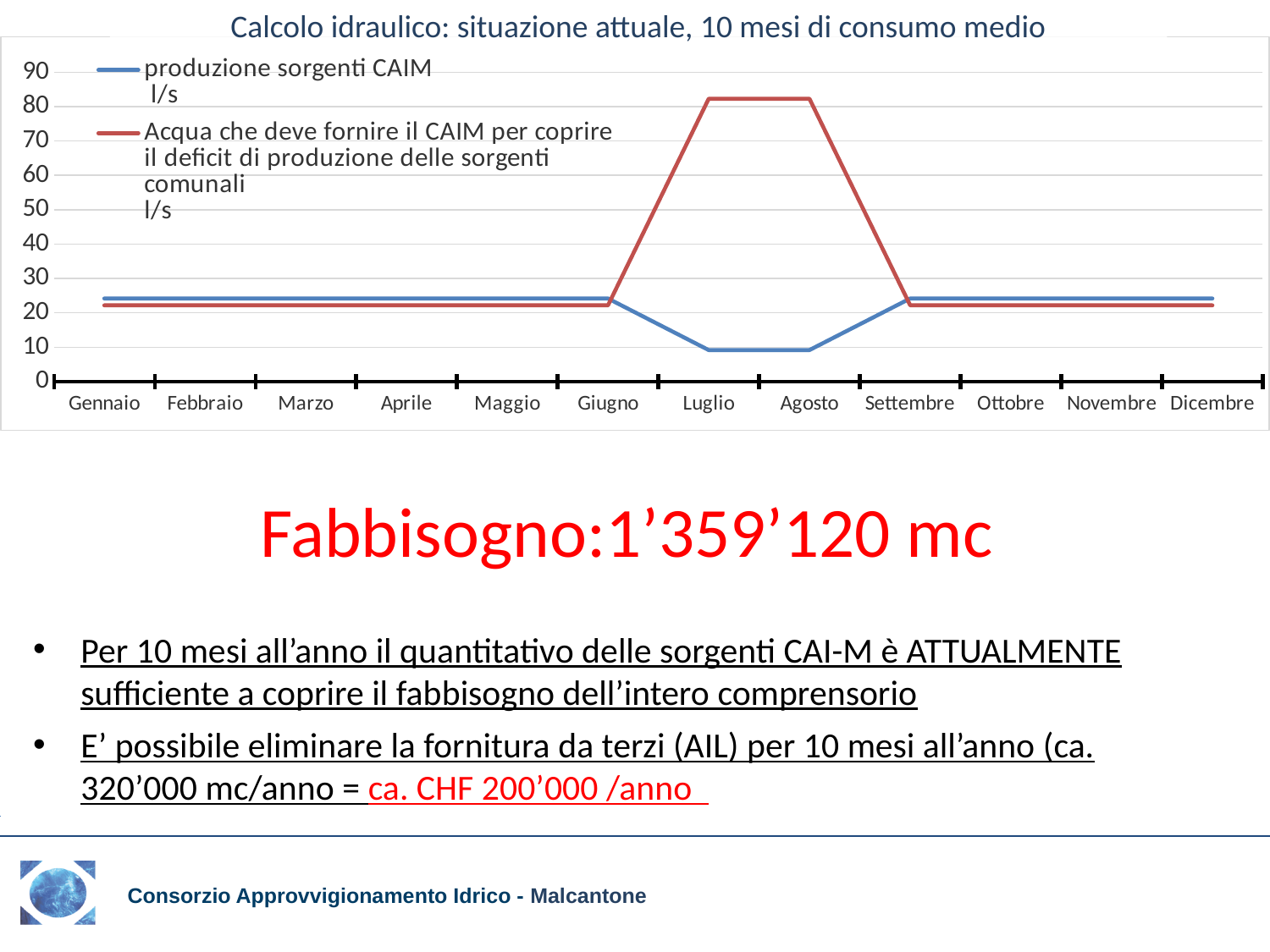
How many months are shown on the x axis of the chart? 12 Which series is drawn in blue in the chart? produzione sorgenti CAIM l/s What kind of chart is shown on the slide? line chart Is the value of the 'Acqua che deve fornire il CAIM' series in Luglio greater or less than 70? greater Is the value of the 'produzione sorgenti CAIM l/s' series in Luglio greater or less than 20? less What is the title of the chart? Calcolo idraulico: situazione attuale, 10 mesi di consumo medio How many series does the chart legend list? 2 Does the 'produzione sorgenti CAIM l/s' series rise or fall from Giugno to Luglio? fall Does the 'Acqua che deve fornire il CAIM' series rise or fall from Agosto to Settembre? fall Is the value of the 'Acqua che deve fornire il CAIM' series in Gennaio greater or less than 30? less In Agosto, which series has the larger value: 'produzione sorgenti CAIM l/s' or 'Acqua che deve fornire il CAIM'? Acqua che deve fornire il CAIM